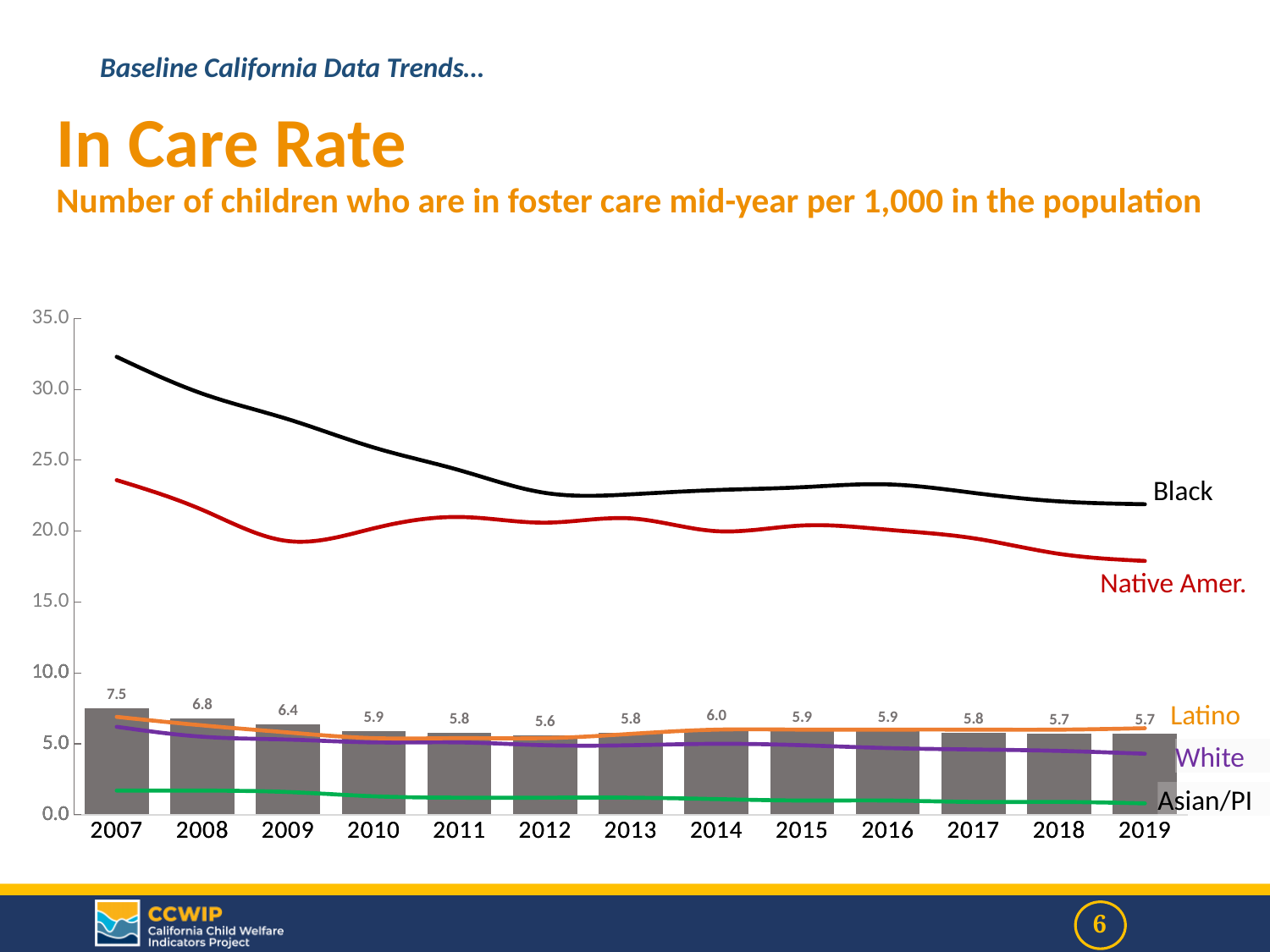
What is the difference between the gray bar values for 2007 and 2019? 1.8 Which labeled line is the highest on the chart? Black What is the value shown on the gray bar for 2007? 7.5 How many years are shown on the x axis? 13 What is the value shown on the gray bar for 2014? 6.0 Which year has the highest gray bar value? 2007 Is the value of the Native Amer. line in 2019 greater or less than 20.0? less Does the Black line rise or fall from 2007 to 2019? fall What is the value shown on the gray bar for 2019? 5.7 Which year has a larger gray bar value, 2008 or 2014? 2008 Which year has the lowest gray bar value? 2012 Is the value of the Black line in 2007 greater or less than 30.0? greater